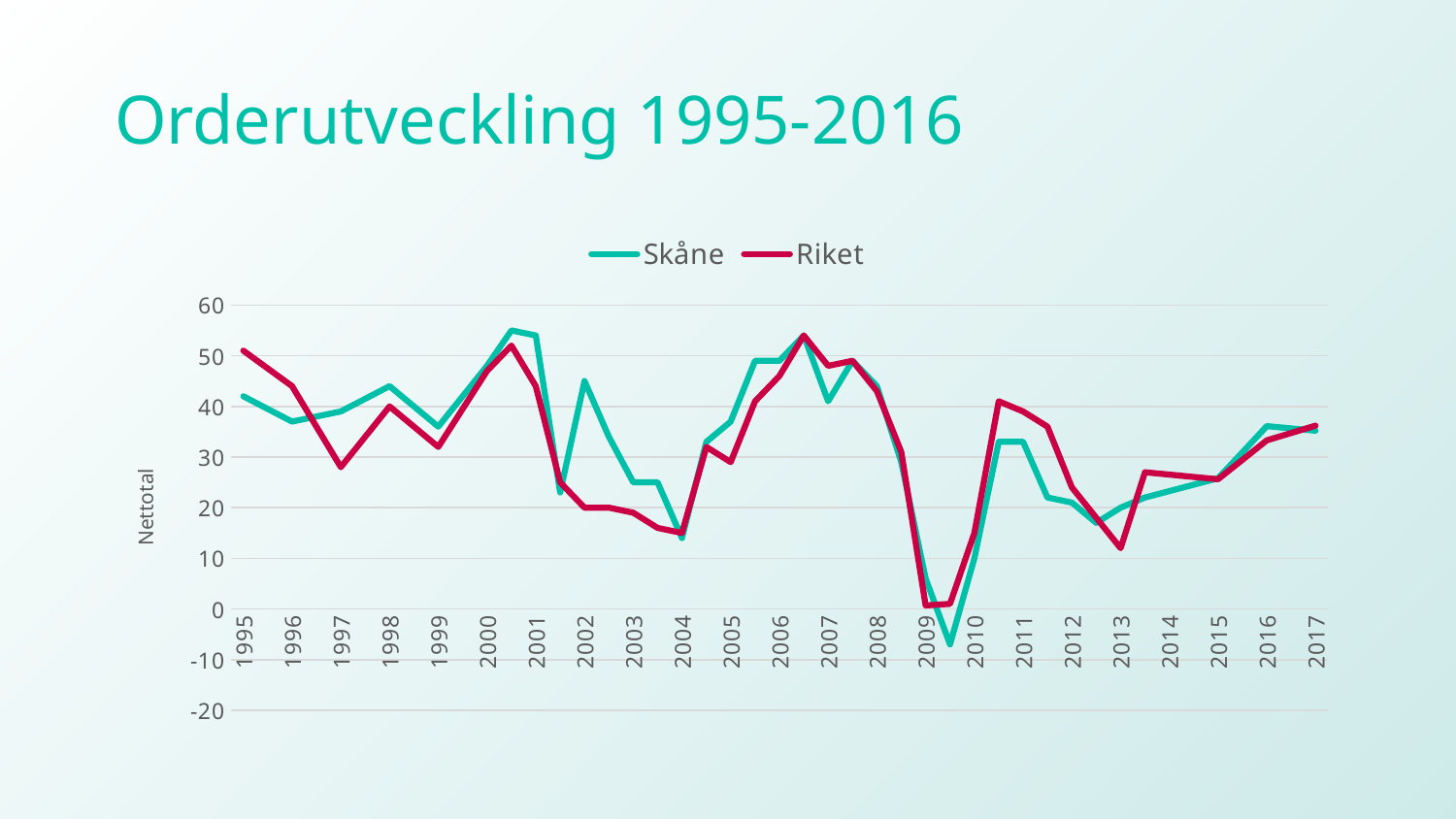
What are the two series named in the legend? Skåne and Riket Is the value for Riket in 1995 greater or less than 40? greater In 1995, which series has the higher value, Skåne or Riket? Riket How many series does the legend list? 2 What is the label on the vertical axis? Nettotal Is the value for Skåne in 2017 greater or less than 30? greater Around which year does the Skåne line reach its lowest point? 2009 How many year labels are shown along the x axis? 23 Do the values for Riket rise or fall between 2013 and 2016? rise What kind of chart is shown on the slide? line chart